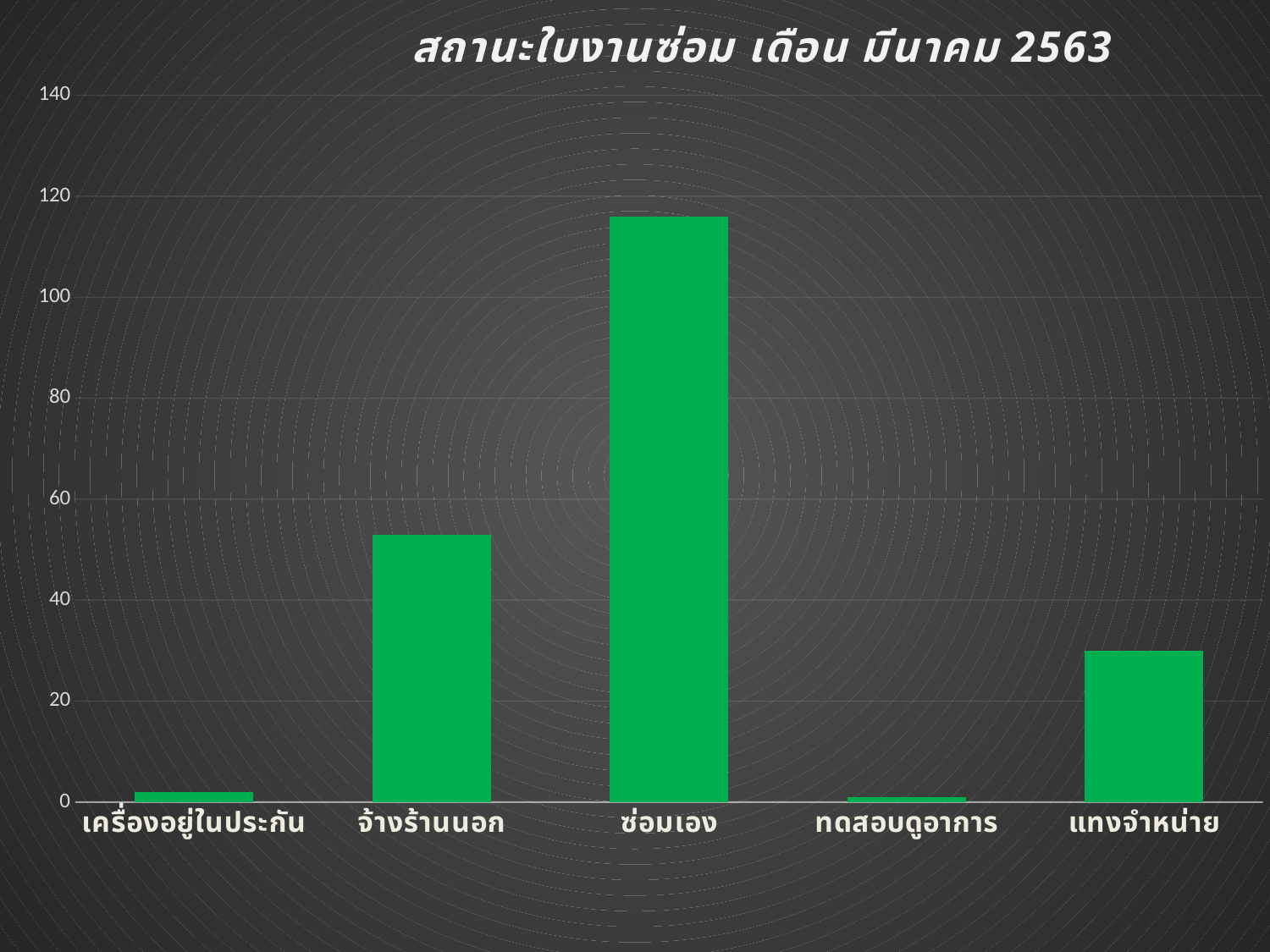
Which is larger, the value for ซ่อมเอง or the value for จ้างร้านนอก? ซ่อมเอง How many categories are shown on the x axis of the chart? 5 Is the value for จ้างร้านนอก greater or less than 60? less Is the value for แทงจำหน่าย greater or less than 40? less Is the value for ซ่อมเอง greater or less than 100? greater What colour are the bars in the chart? Green Which category has the highest value in the chart? ซ่อมเอง Which is larger, the value for จ้างร้านนอก or the value for แทงจำหน่าย? จ้างร้านนอก What is the title of the chart? สถานะใบงานซ่อม เดือน มีนาคม 2563 What type of chart is shown on the slide? Bar chart